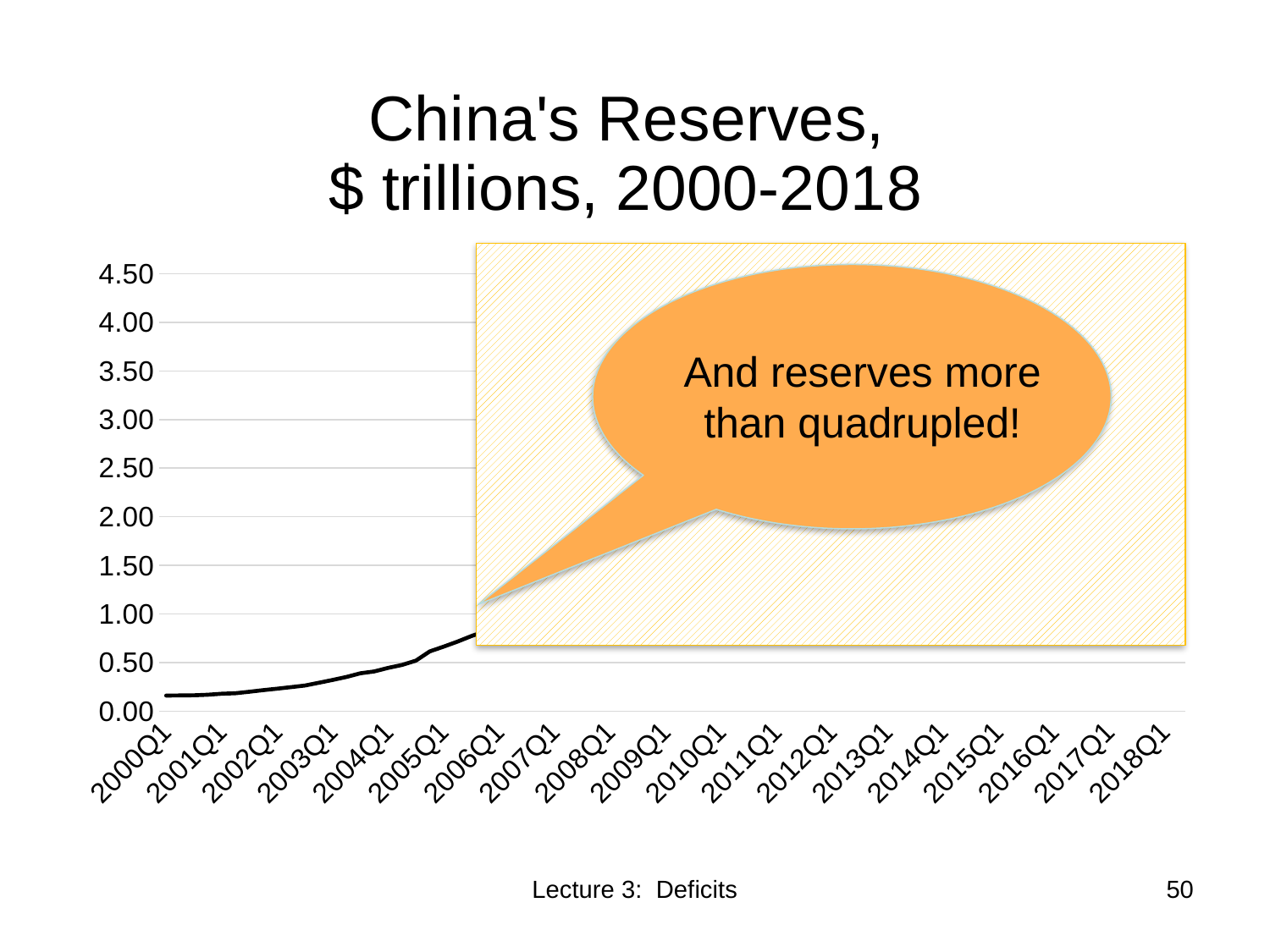
What is the highest tick value shown on the y axis? 4.50 Is the value for 2000Q1 greater or less than 0.50? less Which is larger, the value for 2000Q1 or the value for 2006Q1? 2006Q1 Is the value for 2003Q1 greater or less than 0.50? less What kind of chart is shown on the slide? line chart What is the title of the chart? China's Reserves, $ trillions, 2000-2018 What does the callout on the chart say? And reserves more than quadrupled! Does the visible line rise or fall from 2000Q1 to 2006Q1? rise Is the value for 2006Q1 greater or less than 0.50? greater How many quarter labels are shown on the x axis? 19